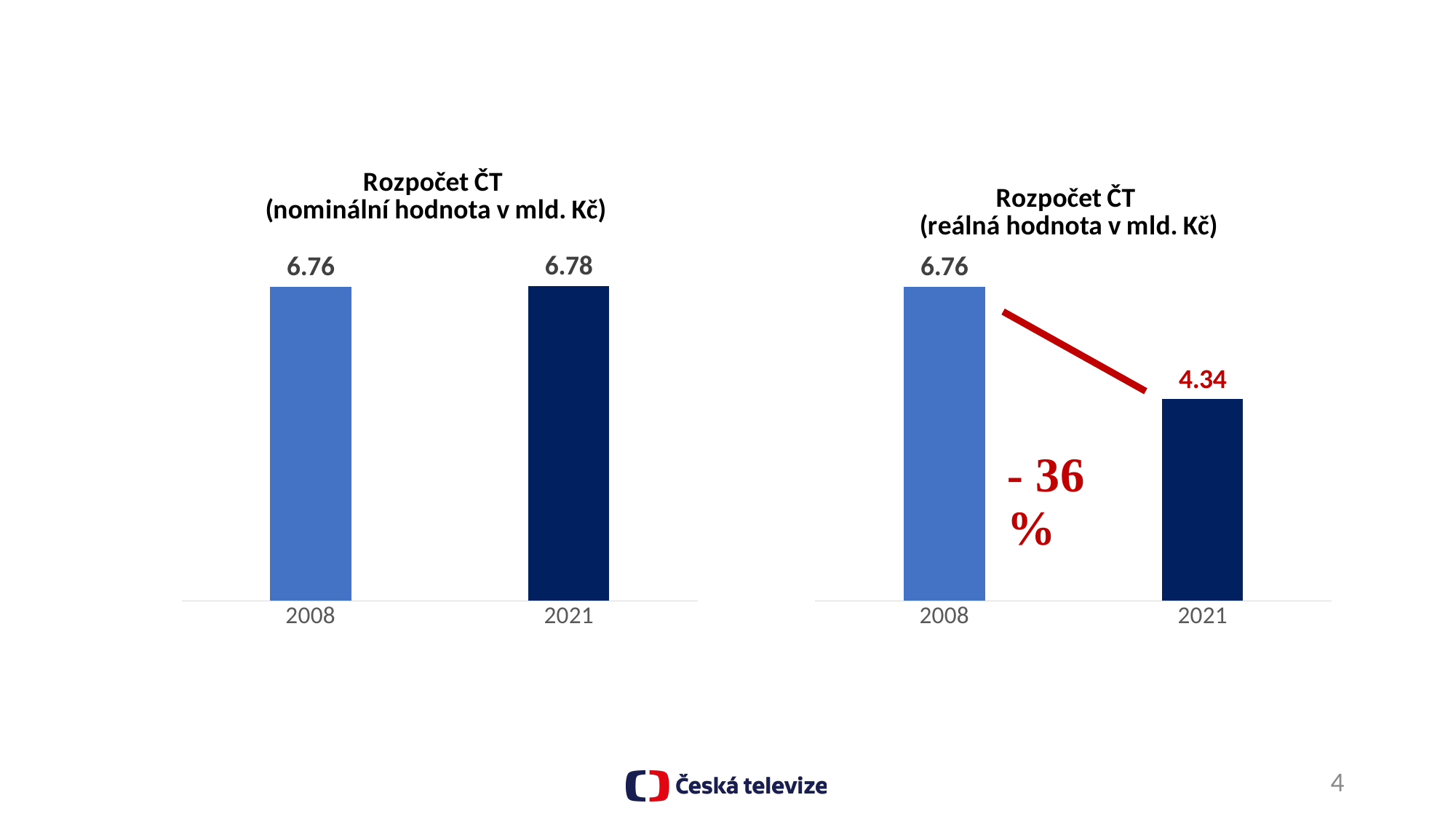
What kind of chart is the right chart (Rozpočet ČT, reálná hodnota v mld. Kč)? bar chart In the left chart (Rozpočet ČT, nominální hodnota v mld. Kč), what is the value for 2021? 6.78 In the right chart (Rozpočet ČT, reálná hodnota v mld. Kč), which year has the highest value? 2008 In the right chart (Rozpočet ČT, reálná hodnota v mld. Kč), what is the value for 2008? 6.76 In the left chart (Rozpočet ČT, nominální hodnota v mld. Kč), what is the value for 2008? 6.76 In the right chart (Rozpočet ČT, reálná hodnota v mld. Kč), what is the difference between the 2008 and 2021 values? 2.42 In the right chart (Rozpočet ČT, reálná hodnota v mld. Kč), which year has the lowest value? 2021 How many categories (years) are shown in the left chart (Rozpočet ČT, nominální hodnota v mld. Kč)? 2 In the right chart (Rozpočet ČT, reálná hodnota v mld. Kč), what is the value for 2021? 4.34 In the right chart (Rozpočet ČT, reálná hodnota v mld. Kč), is the value for 2008 larger or smaller than the value for 2021? larger What percentage change is annotated in red on the right chart (Rozpočet ČT, reálná hodnota v mld. Kč)? - 36 % In the left chart (Rozpočet ČT, nominální hodnota v mld. Kč), what is the difference between the 2021 and 2008 values? 0.02